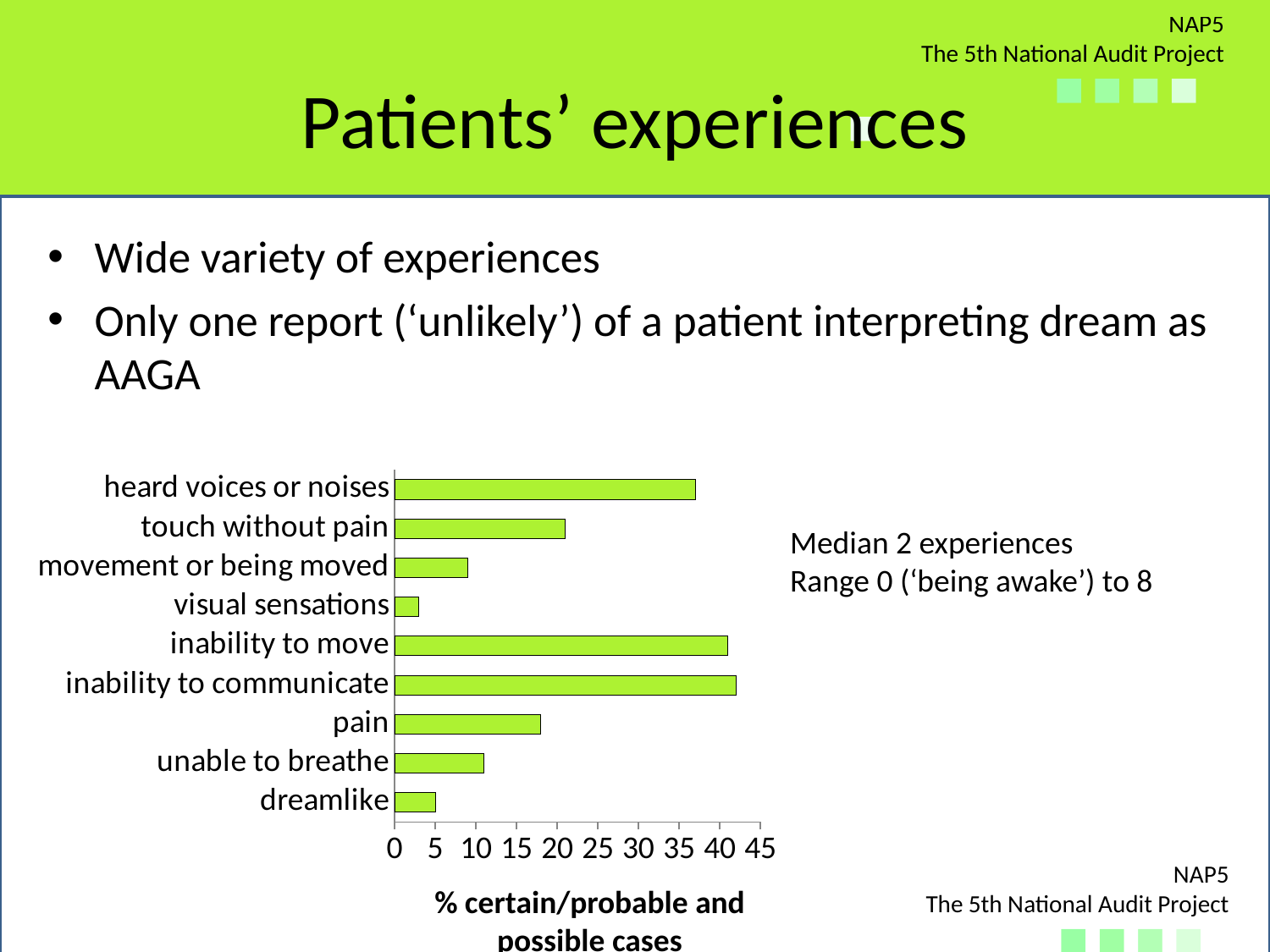
Which has the larger value, 'heard voices or noises' or 'touch without pain'? heard voices or noises What is the label on the horizontal axis of the bar chart? % certain/probable and possible cases Which category has the lowest value in the bar chart? visual sensations Is the value for 'movement or being moved' greater or less than 15? less Which has the larger value, 'pain' or 'unable to breathe'? pain Is the value for 'visual sensations' greater or less than 5? less Is the value for 'dreamlike' greater or less than 10? less What kind of chart is shown on the slide? bar chart How many categories (patient experiences) are plotted in the bar chart? 9